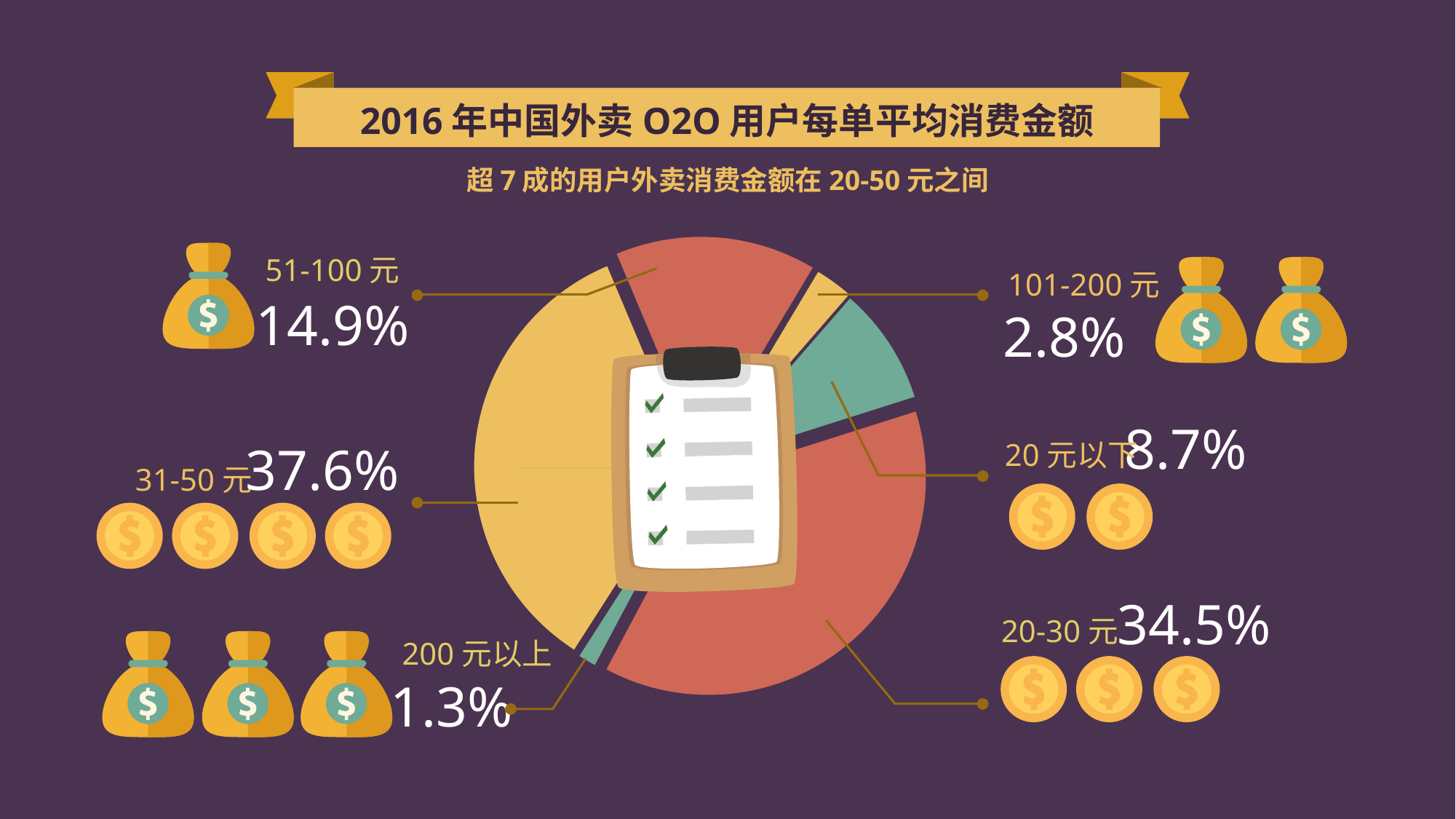
What share of users spend 51-100 元 per order? 14.9% What is the title of the chart? 2016 年中国外卖 O2O 用户每单平均消费金额 What share of users spend 101-200 元 per order? 2.8% Which category has the smallest share of the pie? 200 元以上 Which category has the largest share of the pie? 31-50 元 What share of users spend 200 元以上 per order? 1.3% What share of users spend 20-30 元 per order? 34.5% What kind of chart is shown on the slide? pie chart Which is larger, the share for 20 元以下 or the share for 101-200 元? 20 元以下 What is the difference between the shares for 31-50 元 and 20-30 元? 3.1% What share of users spend 31-50 元 per order? 37.6% How many categories (slices) does the pie chart have? 6